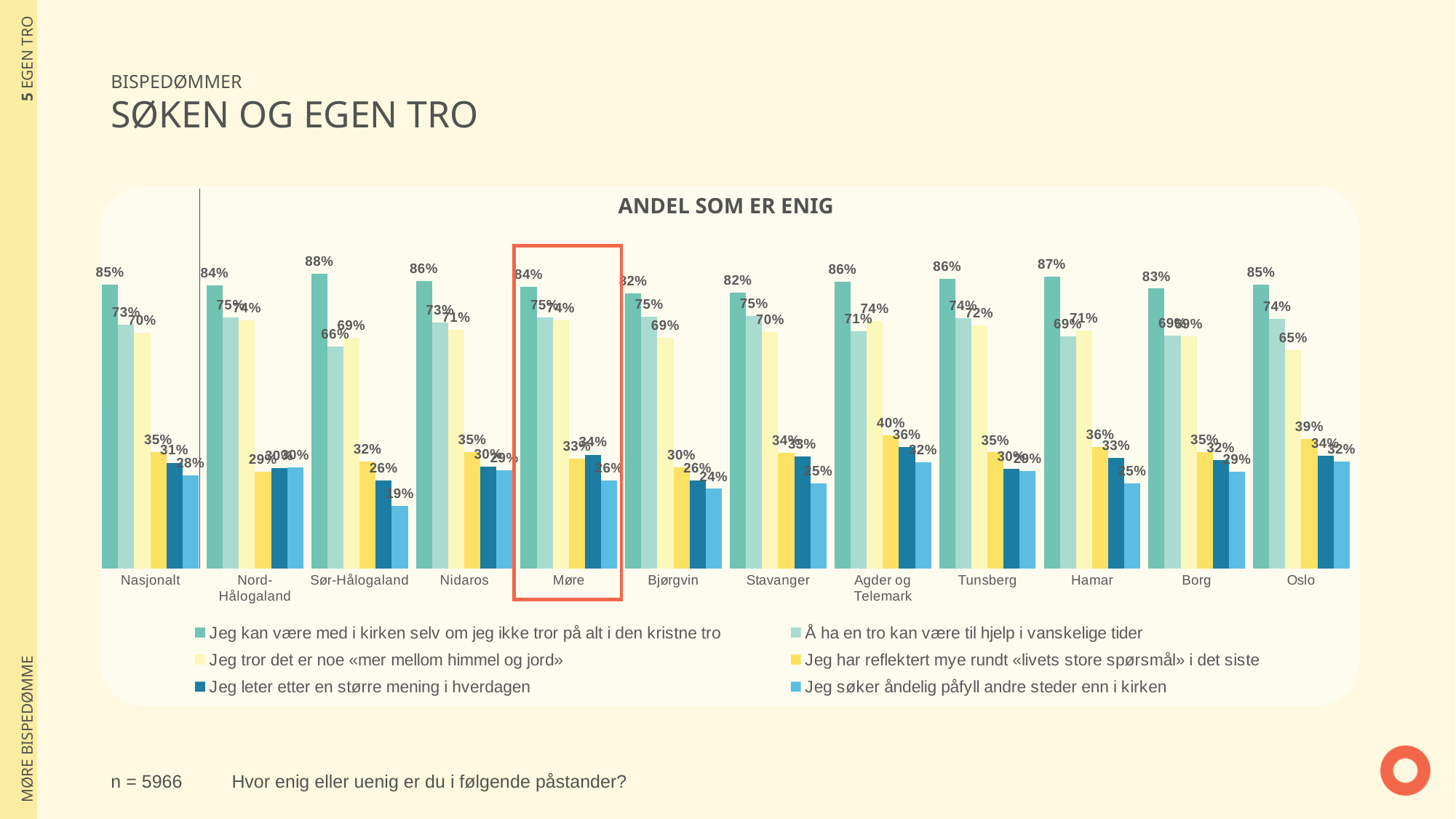
What is the value for Sør-Hålogaland in the series "Jeg søker åndelig påfyll andre steder enn i kirken"? 19% How many series does the legend list? 6 What is the difference between the Nasjonalt value and the Sør-Hålogaland value in the series "Jeg kan være med i kirken selv om jeg ikke tror på alt i den kristne tro"? 3% In the series "Jeg har reflektert mye rundt «livets store spørsmål» i det siste", which is larger: Oslo or Nasjonalt? Oslo How many categories (bispedømmer including Nasjonalt) are shown on the x axis? 12 What is the value for Agder og Telemark in the series "Jeg har reflektert mye rundt «livets store spørsmål» i det siste"? 40% Which category has the highest value in the series "Jeg kan være med i kirken selv om jeg ikke tror på alt i den kristne tro"? Sør-Hålogaland Which category has the lowest value in the series "Jeg søker åndelig påfyll andre steder enn i kirken"? Sør-Hålogaland What is the value for Oslo in the series "Jeg tror det er noe «mer mellom himmel og jord»"? 65% What kind of chart is shown on the slide? Bar chart What is the value for Sør-Hålogaland in the series "Jeg kan være med i kirken selv om jeg ikke tror på alt i den kristne tro"? 88% What is the title of the chart? ANDEL SOM ER ENIG